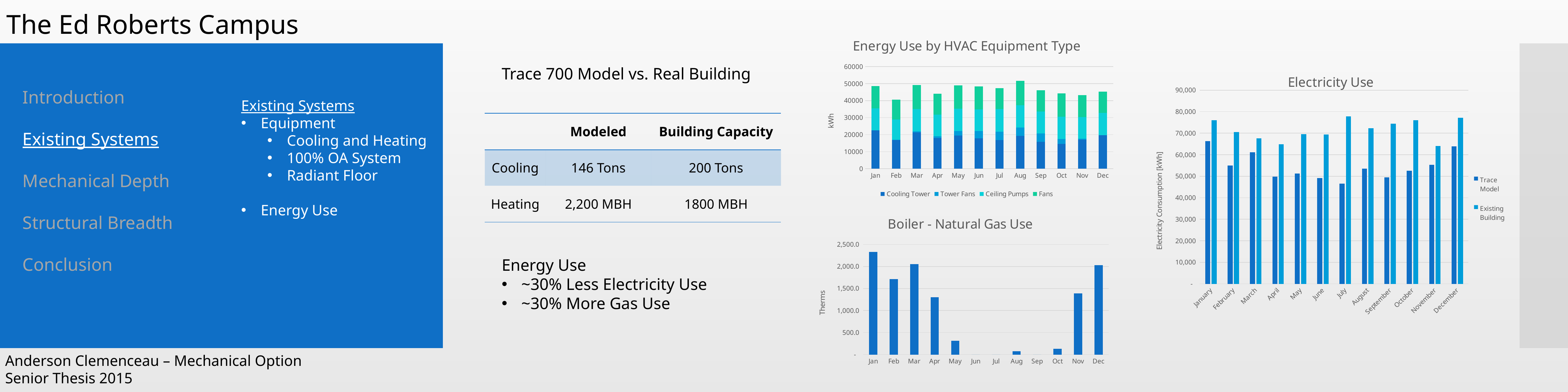
In the 'Boiler - Natural Gas Use' chart, which month has the highest value? Jan In the 'Energy Use by HVAC Equipment Type' chart, which month has the tallest stacked bar? Aug How many series does the legend of the 'Electricity Use' chart list? 2 In the 'Boiler - Natural Gas Use' chart, is the value for Jan greater or less than 2,000.0? greater In the 'Boiler - Natural Gas Use' chart, which is larger, the value for Feb or the value for Mar? Mar What kind of chart is the 'Boiler - Natural Gas Use' chart? bar chart In the 'Boiler - Natural Gas Use' chart, is the value for Apr greater or less than 1,500.0? less How many series does the legend of the 'Energy Use by HVAC Equipment Type' chart list? 4 In the 'Electricity Use' chart, which is larger for January, the Trace Model value or the Existing Building value? Existing Building How many months are shown on the x axis of the 'Boiler - Natural Gas Use' chart? 12 In the 'Electricity Use' chart, is the Existing Building value for April greater or less than 70,000? less